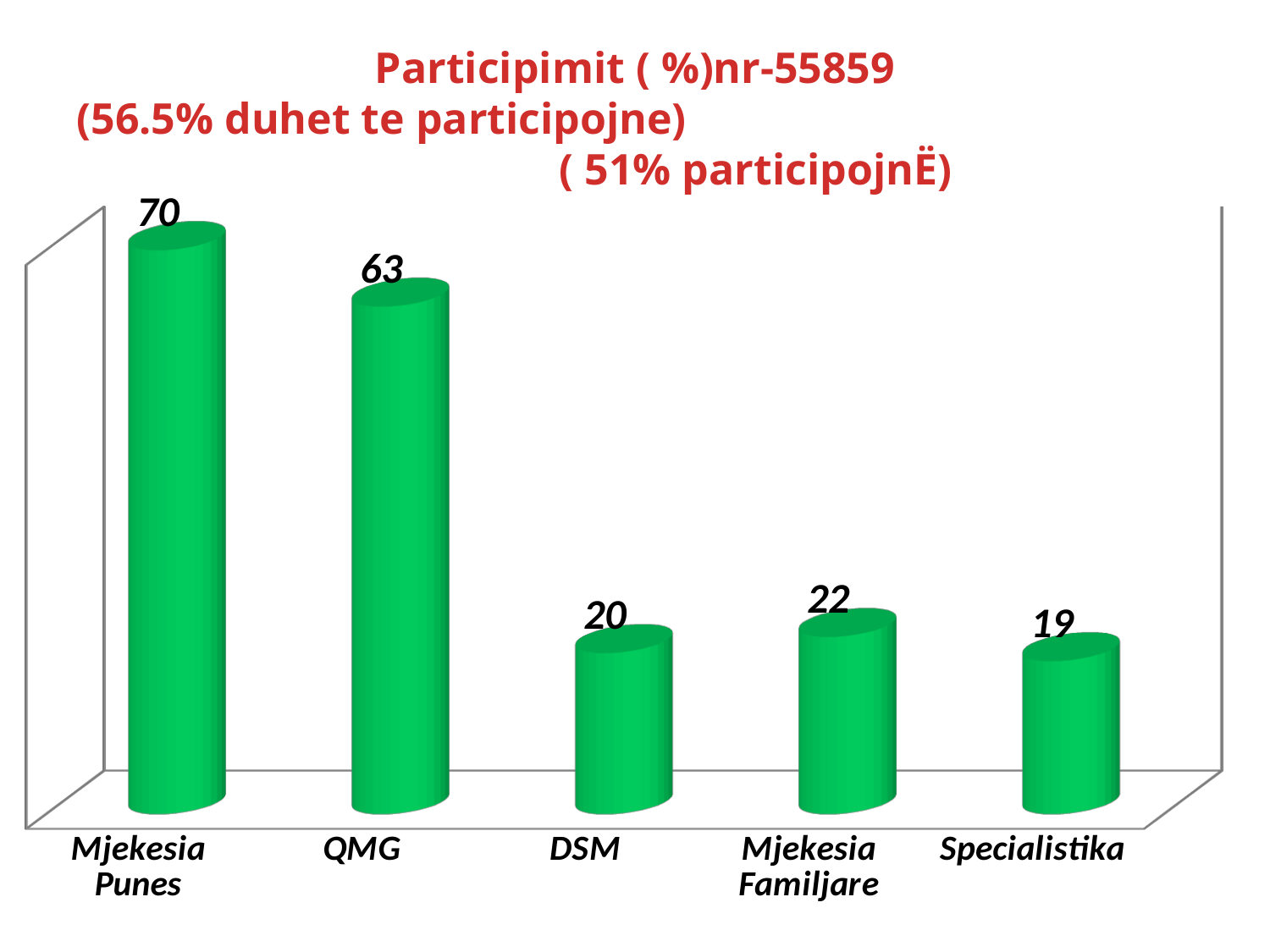
Which is larger, the value for DSM or the value for Mjekesia Familjare? Mjekesia Familjare How many categories are shown in the chart? 5 What is the value for Mjekesia Punes? 70 What is the value for QMG? 63 Which category has the lowest value? Specialistika What is the value for DSM? 20 What colour are the bars in the chart? green What is the value for Specialistika? 19 What is the difference between the values for Mjekesia Punes and QMG? 7 What kind of chart is shown on the slide? bar chart Which category has the highest value? Mjekesia Punes What is the value for Mjekesia Familjare? 22